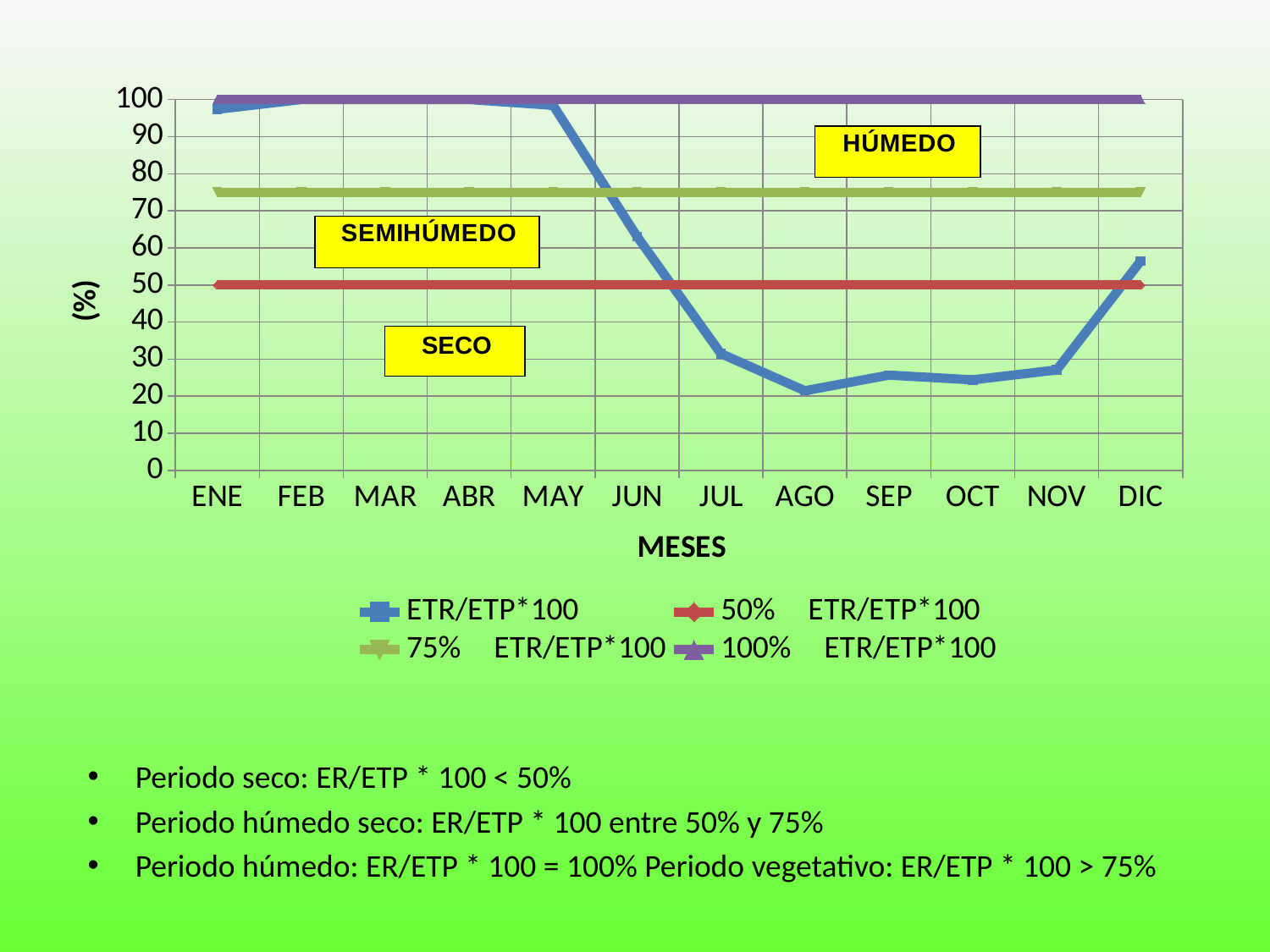
Is the ETR/ETP*100 value for JUN greater or less than 50? greater How many series does the legend list? 4 What kind of chart is shown on the slide? line chart How many months are shown on the x axis? 12 Is the ETR/ETP*100 value for MAR greater or less than 90? greater What value does the '75% ETR/ETP*100' line sit at throughout the year? 75 Is the ETR/ETP*100 value for AGO greater or less than 30? less In which month is the ETR/ETP*100 value lowest? AGO What is the title of the x axis? MESES What value does the '50% ETR/ETP*100' line sit at throughout the year? 50 Which month has the larger ETR/ETP*100 value, JUN or JUL? JUN Does the ETR/ETP*100 line rise or fall from MAY to AGO? fall